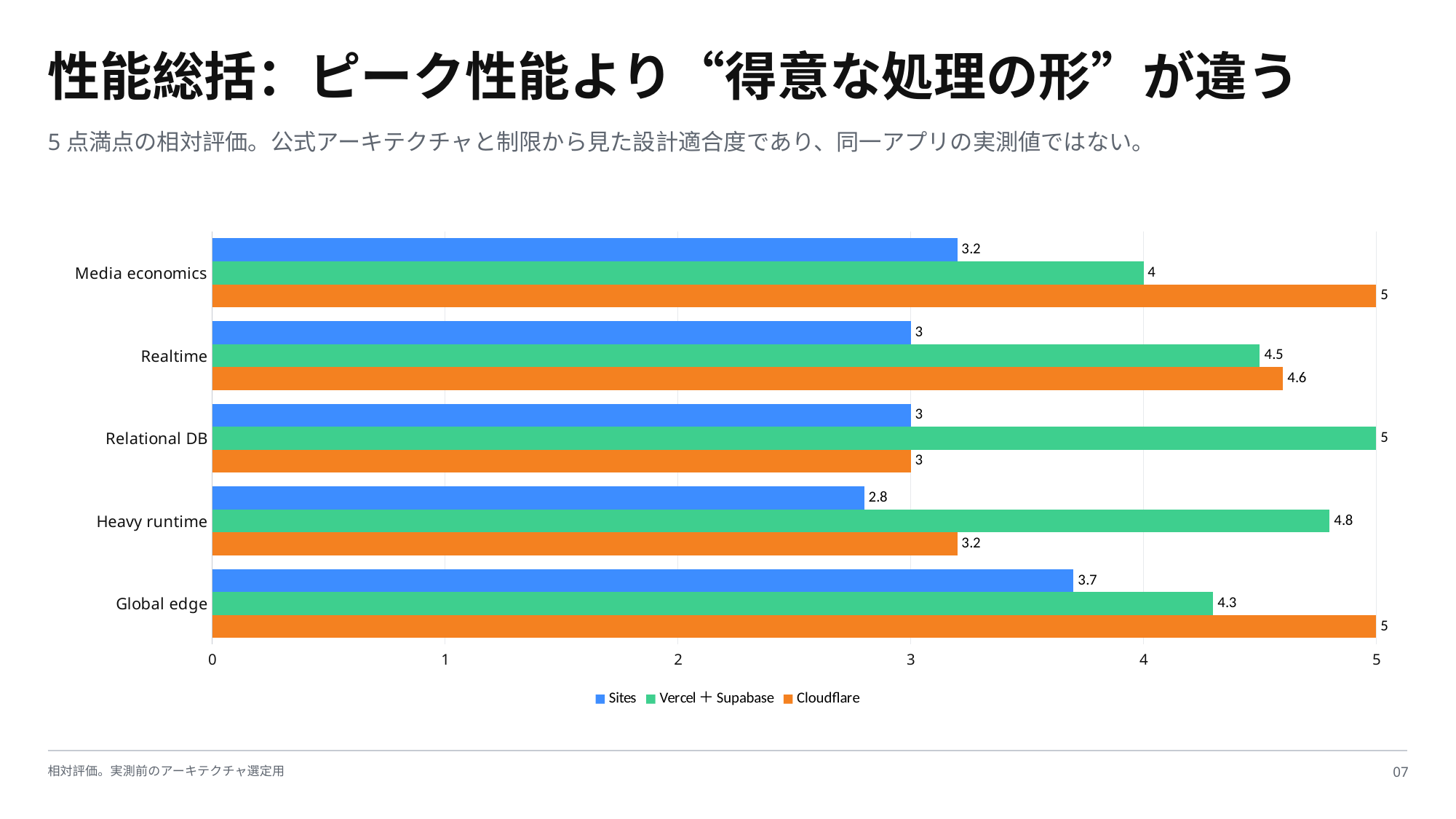
What is the Sites value for Heavy runtime? 2.8 How many categories are shown on the chart? 5 What is the Cloudflare value for Media economics? 5 What is the difference between the Vercel + Supabase and Cloudflare values for Heavy runtime? 1.6 Which series is shown in orange in the legend? Cloudflare How many series does the legend list? 3 Which category has the lowest Sites value? Heavy runtime Which category has the highest Vercel + Supabase value? Relational DB What is the Vercel + Supabase value for Realtime? 4.5 For Relational DB, which is larger: the Vercel + Supabase value or the Cloudflare value? Vercel + Supabase What kind of chart is shown on the slide? Bar chart What is the difference between the Cloudflare and Sites values for Global edge? 1.3